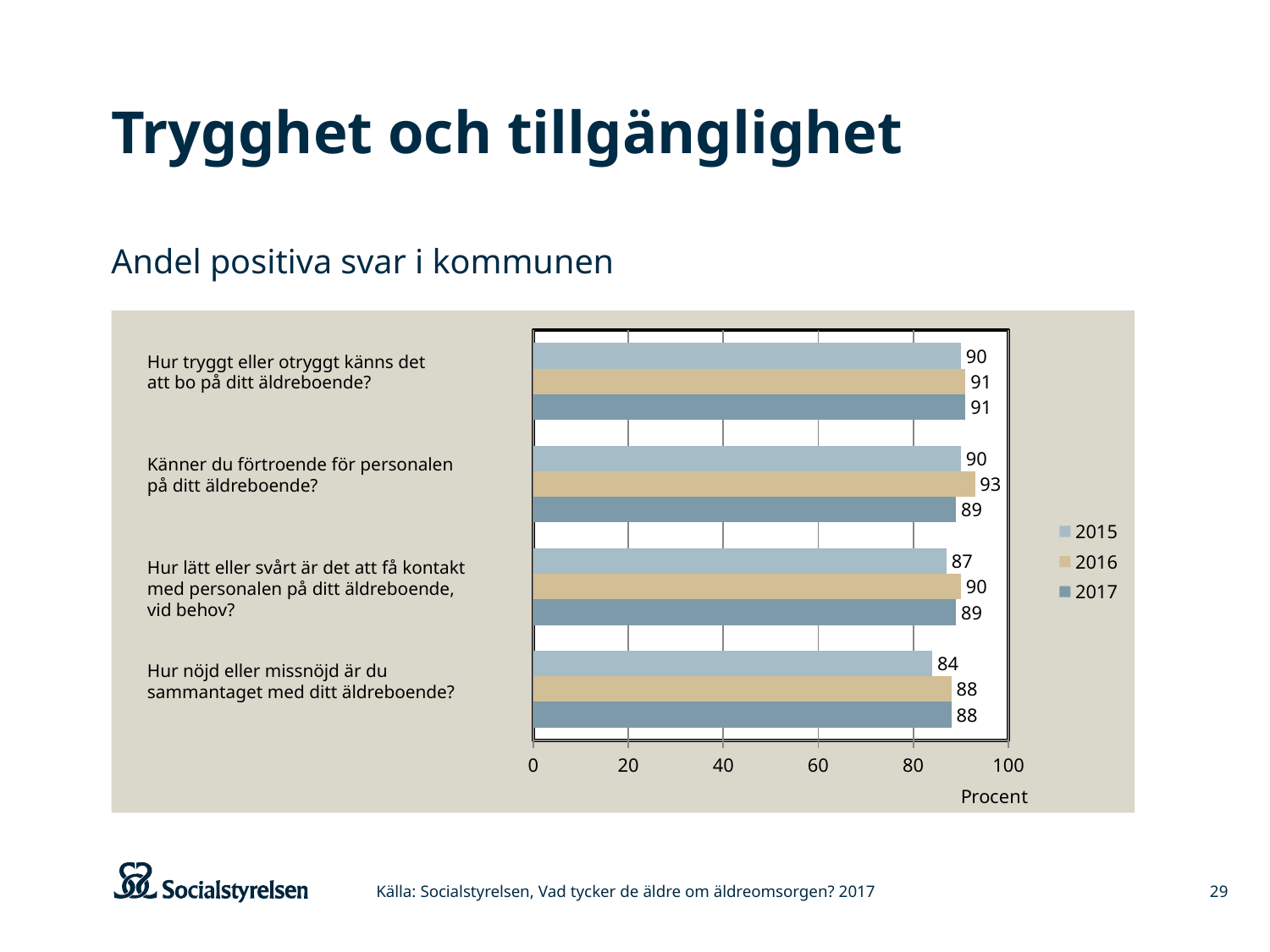
What type of chart is shown on the slide? bar chart How many series does the legend list? 3 Is the 2015 value for "Hur tryggt eller otryggt känns det att bo på ditt äldreboende?" greater or less than 80? greater What is the label on the horizontal axis of the chart? Procent What is the 2016 value for "Känner du förtroende för personalen på ditt äldreboende?"? 93 How many question categories are plotted in the chart? 4 Which category has the lowest 2015 value? Hur nöjd eller missnöjd är du sammantaget med ditt äldreboende? What is the difference between the 2016 and 2015 values for "Hur nöjd eller missnöjd är du sammantaget med ditt äldreboende?"? 4 What is the 2015 value for "Hur nöjd eller missnöjd är du sammantaget med ditt äldreboende?"? 84 What is the 2017 value for "Hur lätt eller svårt är det att få kontakt med personalen på ditt äldreboende, vid behov?"? 89 Which category has the highest 2016 value? Känner du förtroende för personalen på ditt äldreboende? For "Känner du förtroende för personalen på ditt äldreboende?", which is larger: the 2016 value or the 2017 value? 2016